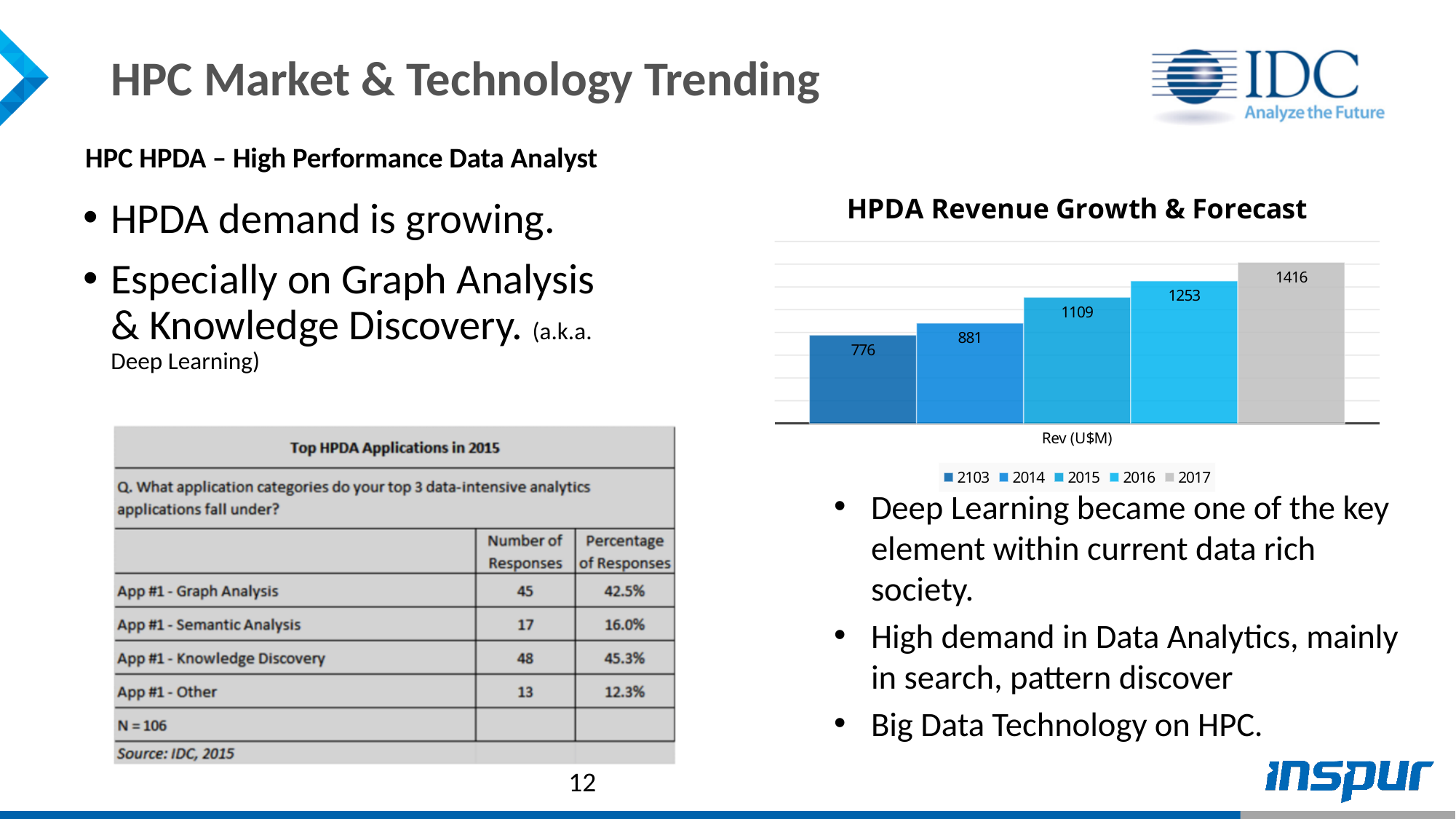
In the HPDA Revenue Growth & Forecast chart, what is the value for 2017? 1416 In the HPDA Revenue Growth & Forecast chart, do the values rise or fall from left to right? rise In the HPDA Revenue Growth & Forecast chart, which year has the highest revenue? 2017 In the HPDA Revenue Growth & Forecast chart, which series has the lowest value? 2103 In the HPDA Revenue Growth & Forecast chart, what is the value for 2016? 1253 In the HPDA Revenue Growth & Forecast chart, what is the difference between the 2017 value and the 2016 value? 163 In the HPDA Revenue Growth & Forecast chart, which is larger, the value for 2015 or the value for 2014? 2015 What type of chart is the HPDA Revenue Growth & Forecast chart? bar chart In the HPDA Revenue Growth & Forecast chart, what is the value for 2015? 1109 What is the x-axis category label shown under the bars in the HPDA Revenue Growth & Forecast chart? Rev (U$M) In the HPDA Revenue Growth & Forecast chart, what is the value for 2014? 881 How many series does the legend of the HPDA Revenue Growth & Forecast chart list? 5